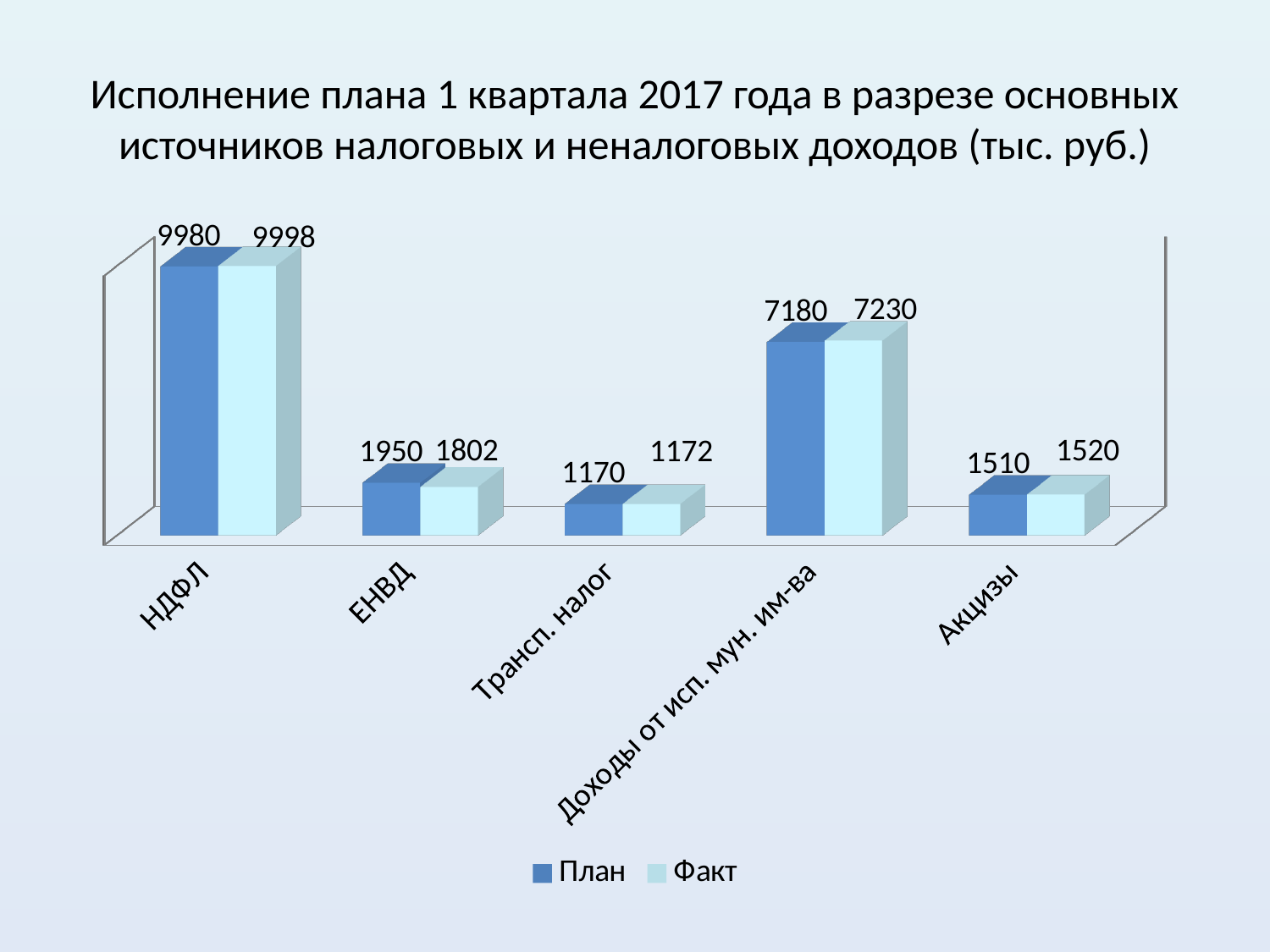
What is the difference between the Факт and План values for НДФЛ? 18 How many series does the legend list? 2 What is the Факт value for Доходы от исп. мун. им-ва? 7230 Which is larger for Доходы от исп. мун. им-ва, the План value or the Факт value? Факт Which category has the highest Факт value? НДФЛ What is the difference between the План and Факт values for ЕНВД? 148 What kind of chart is shown on the slide? Bar chart How many categories are shown on the x axis? 5 Which category has the lowest План value? Трансп. налог What is the План value for Акцизы? 1510 What is the Факт value for ЕНВД? 1802 What is the План value for НДФЛ? 9980